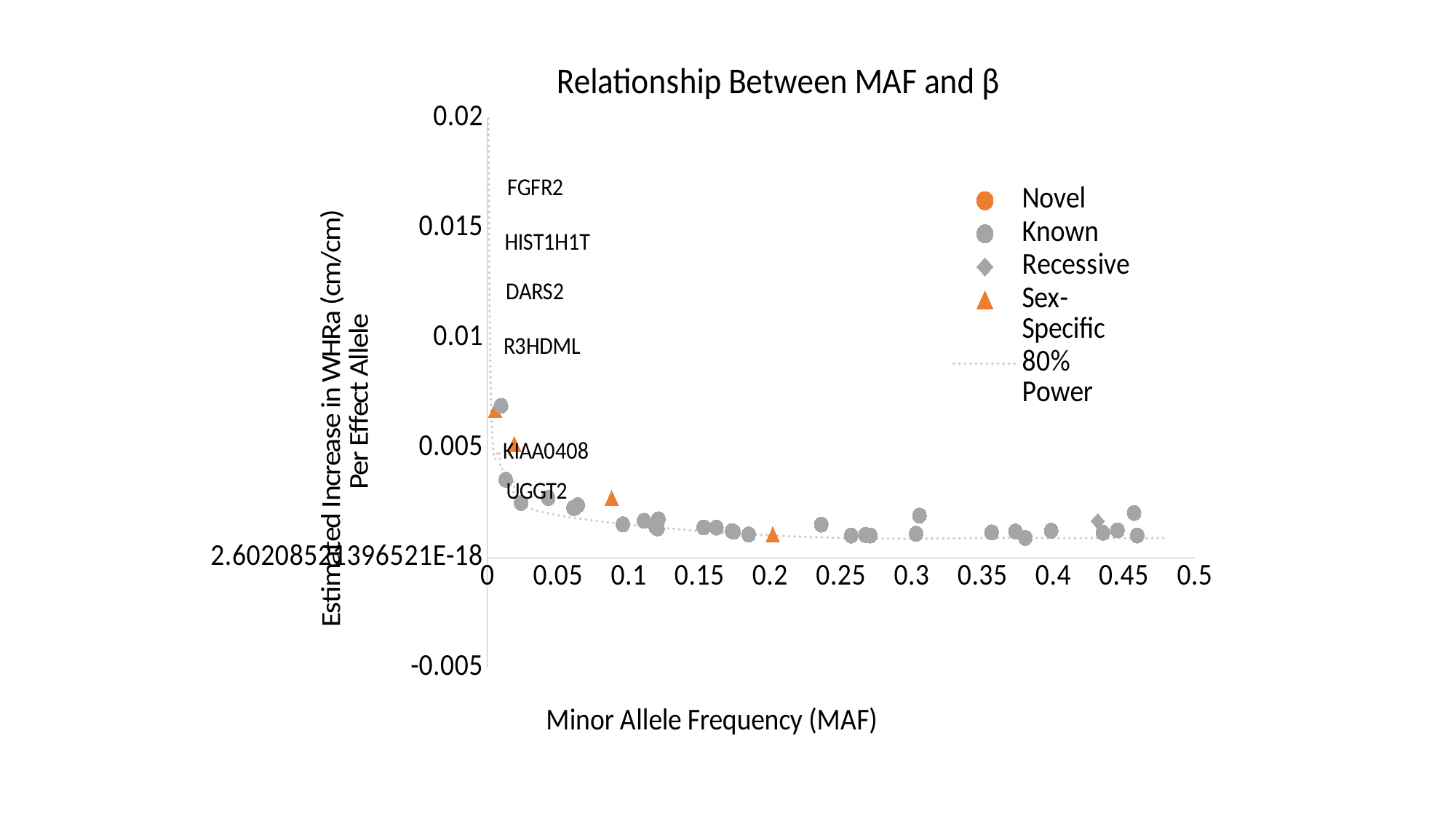
What is the highest tick value shown on the x axis? 0.5 What kind of chart is shown on the slide? scatter chart Is the value for the Sex-Specific point at MAF 0.2 greater or less than 0.005? less What is the title of the chart? Relationship Between MAF and β How many series does the legend list? 5 Do the plotted values generally rise or fall as MAF increases along the x axis? fall What is the label of the x axis? Minor Allele Frequency (MAF) Are the Known points plotted between MAF 0.35 and 0.45 greater or less than 0.005? less Which legend entry is drawn as a dotted line rather than a marker? 80% Power Is the value for the Sex-Specific point near MAF 0.09 greater or less than 0.005? less